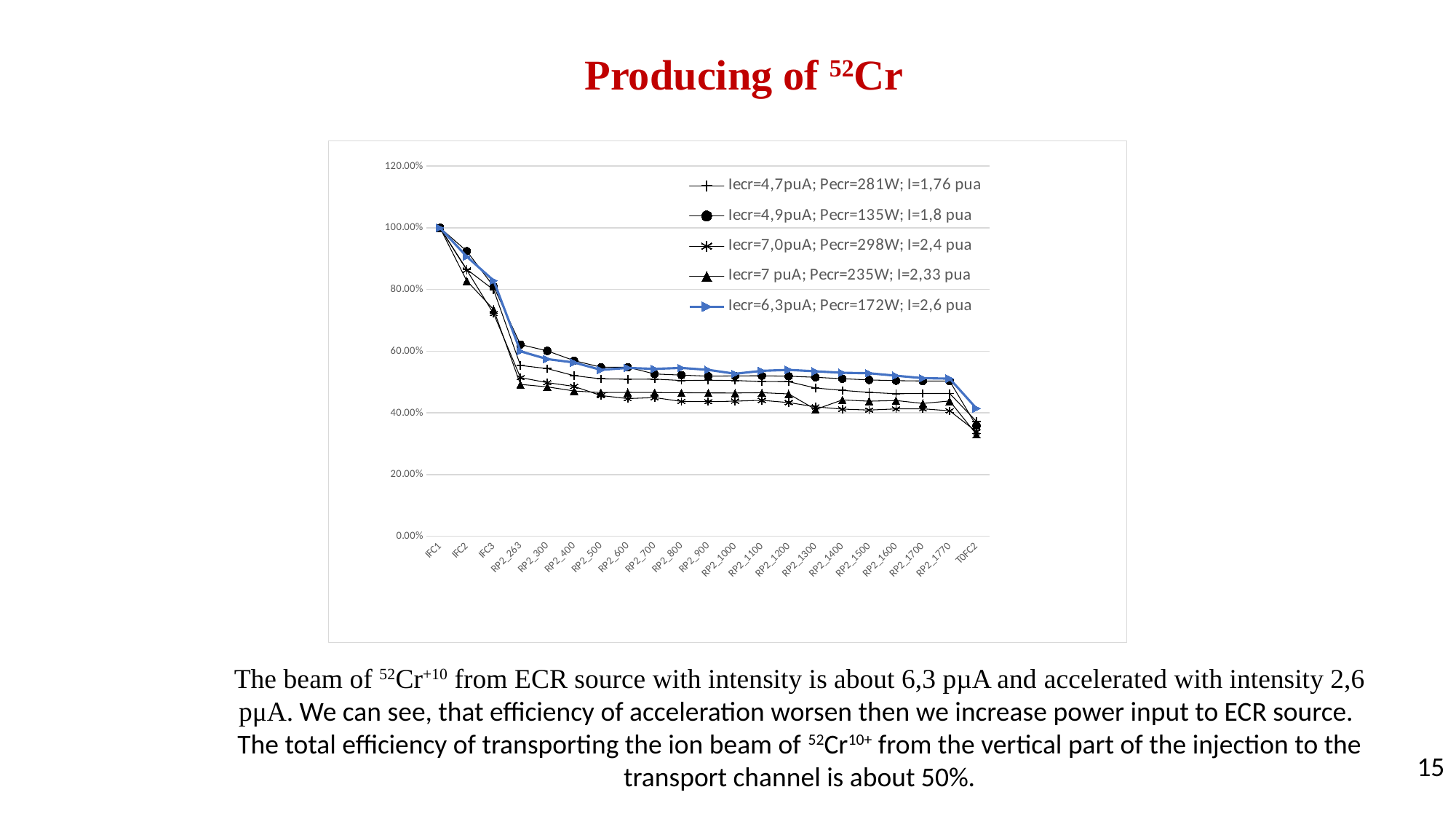
Do the values of the series generally rise or fall from IFC1 to T0FC2? fall What is the value of the series Iecr=6,3puA; Pecr=172W; I=2,6 pua at IFC1? 100.00% At which category does the series Iecr=6,3puA; Pecr=172W; I=2,6 pua reach its lowest value? T0FC2 How many categories are on the x axis of the chart? 21 What kind of chart is shown on the slide? line chart Is the value for the series Iecr=7,0puA; Pecr=298W; I=2,4 pua at RP2_1300 greater or less than 60%? less Which series is drawn with a blue line? Iecr=6,3puA; Pecr=172W; I=2,6 pua Is the value for the series Iecr=4,9puA; Pecr=135W; I=1,8 pua at IFC2 greater or less than 80%? greater How many series does the legend list? 5 What is the highest tick label on the y axis? 120.00% At T0FC2, which series has the larger value: Iecr=6,3puA; Pecr=172W; I=2,6 pua or Iecr=7,0puA; Pecr=298W; I=2,4 pua? Iecr=6,3puA; Pecr=172W; I=2,6 pua Is the value for the series Iecr=6,3puA; Pecr=172W; I=2,6 pua at RP2_263 greater or less than 80%? less